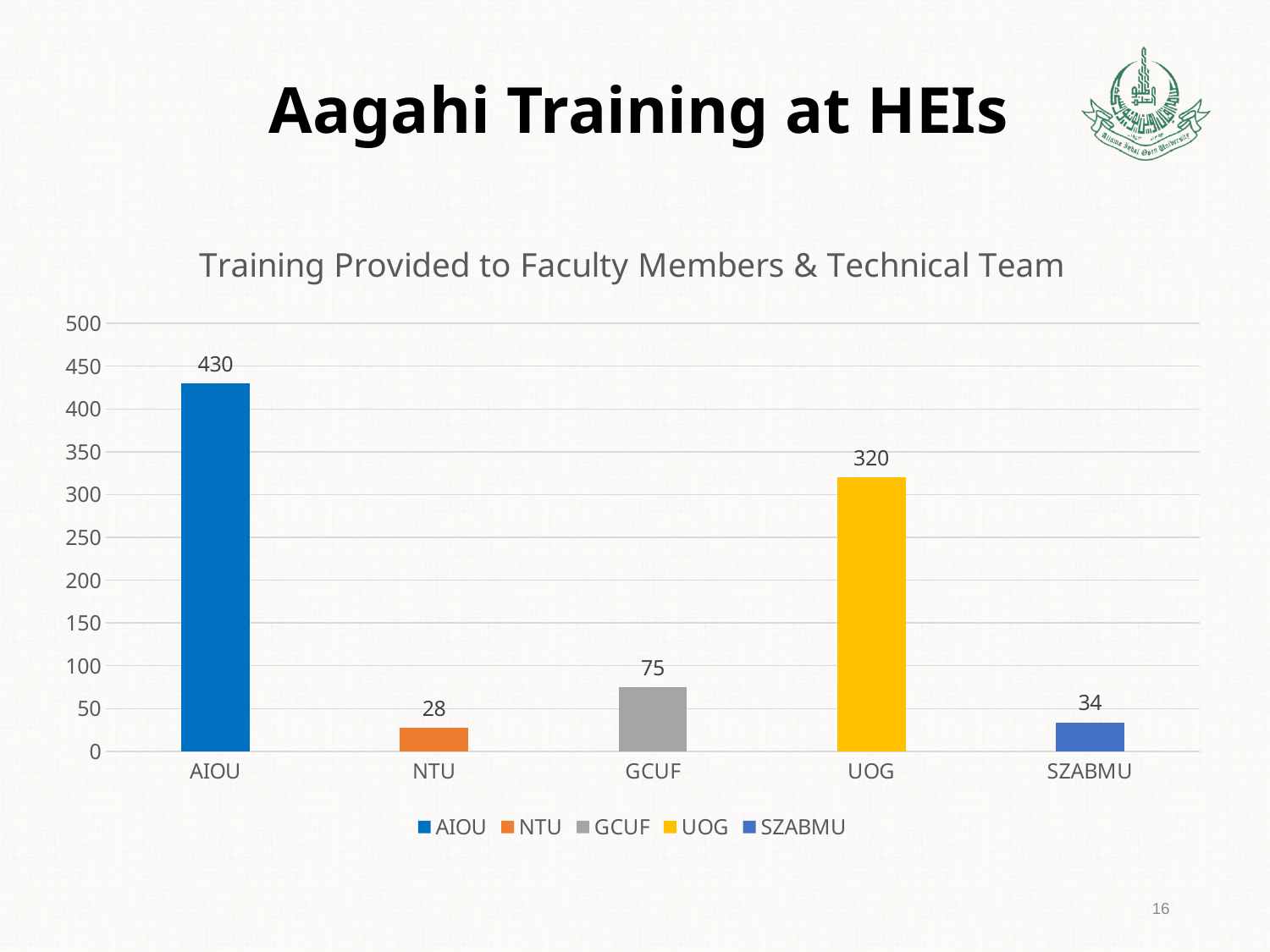
Which is larger, the value for GCUF or the value for SZABMU? GCUF What kind of chart is shown on the slide? bar chart What is the value for SZABMU? 34 What is the value for NTU? 28 Which category has the lowest value? NTU What is the value for AIOU? 430 How many categories are shown on the x axis? 5 What is the difference between the values for AIOU and UOG? 110 What is the value for UOG? 320 Which category has the highest value? AIOU Is the value for GCUF greater or less than 100? less What is the title of the chart? Training Provided to Faculty Members & Technical Team